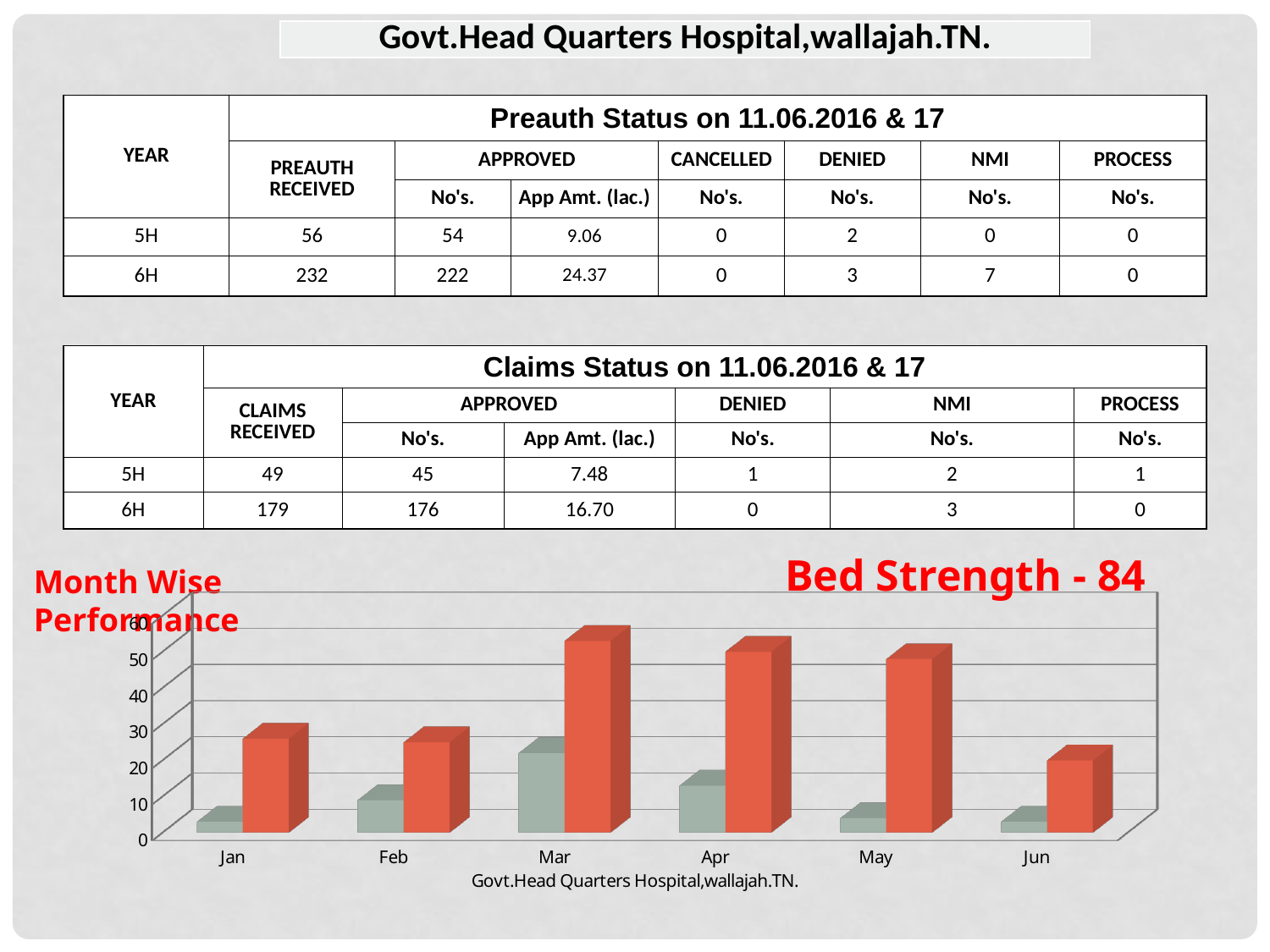
In the bar chart, is the grey bar for Mar or the grey bar for Apr taller? Mar In the bar chart, is the red bar for Jan or the grey bar for Jan taller? red bar In the bar chart, which month has the tallest grey bar? Mar How many months are shown on the x axis of the bar chart? 6 In the bar chart, which month has the shortest red bar? Jun In the bar chart, which month has the tallest red bar? Mar Is the red bar for Mar greater or less than 40? greater What kind of chart is shown at the bottom of the slide? bar chart Is the grey bar for Mar greater or less than 10? greater Is the red bar for Jan greater or less than 40? less What title is printed beneath the bar chart's x axis? Govt.Head Quarters Hospital,wallajah.TN.